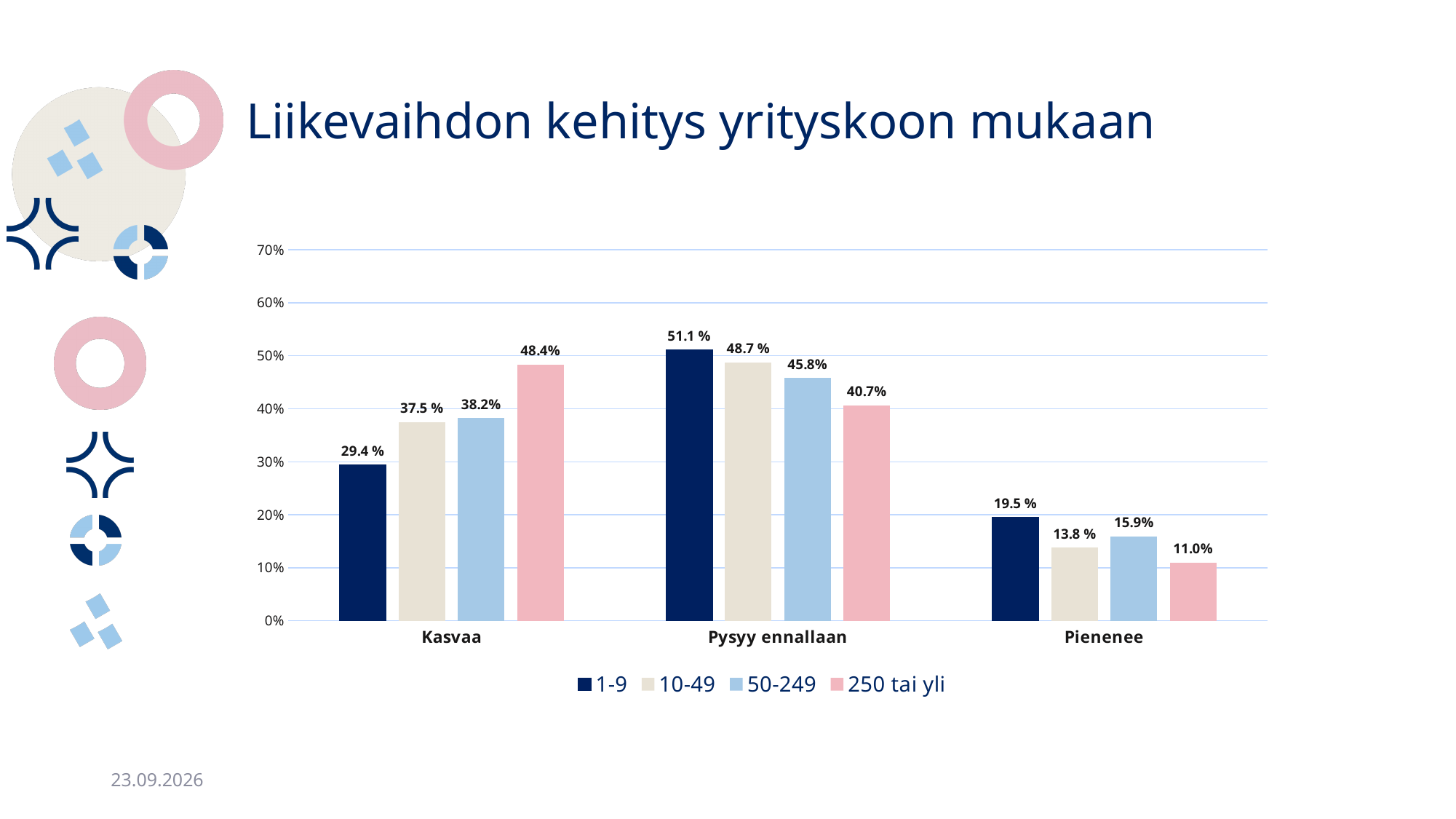
How many categories are shown on the x axis? 3 Is the value for 1-9 in the Pysyy ennallaan category greater or less than 50%? greater What kind of chart is shown on the slide? Bar chart How many series does the legend list? 4 What is the value for the 1-9 series in the Kasvaa category? 29.4 % What is the title of the slide? Liikevaihdon kehitys yrityskoon mukaan What is the value for the 250 tai yli series in the Pysyy ennallaan category? 40.7% Which series has the highest value in the Kasvaa category? 250 tai yli What is the value for the 50-249 series in the Pienenee category? 15.9% Which series has the lowest value in the Pienenee category? 250 tai yli What is the difference between the 1-9 and 10-49 values in the Pysyy ennallaan category? 2.4 percentage points Which is larger in the Kasvaa category: the 10-49 value or the 50-249 value? 50-249